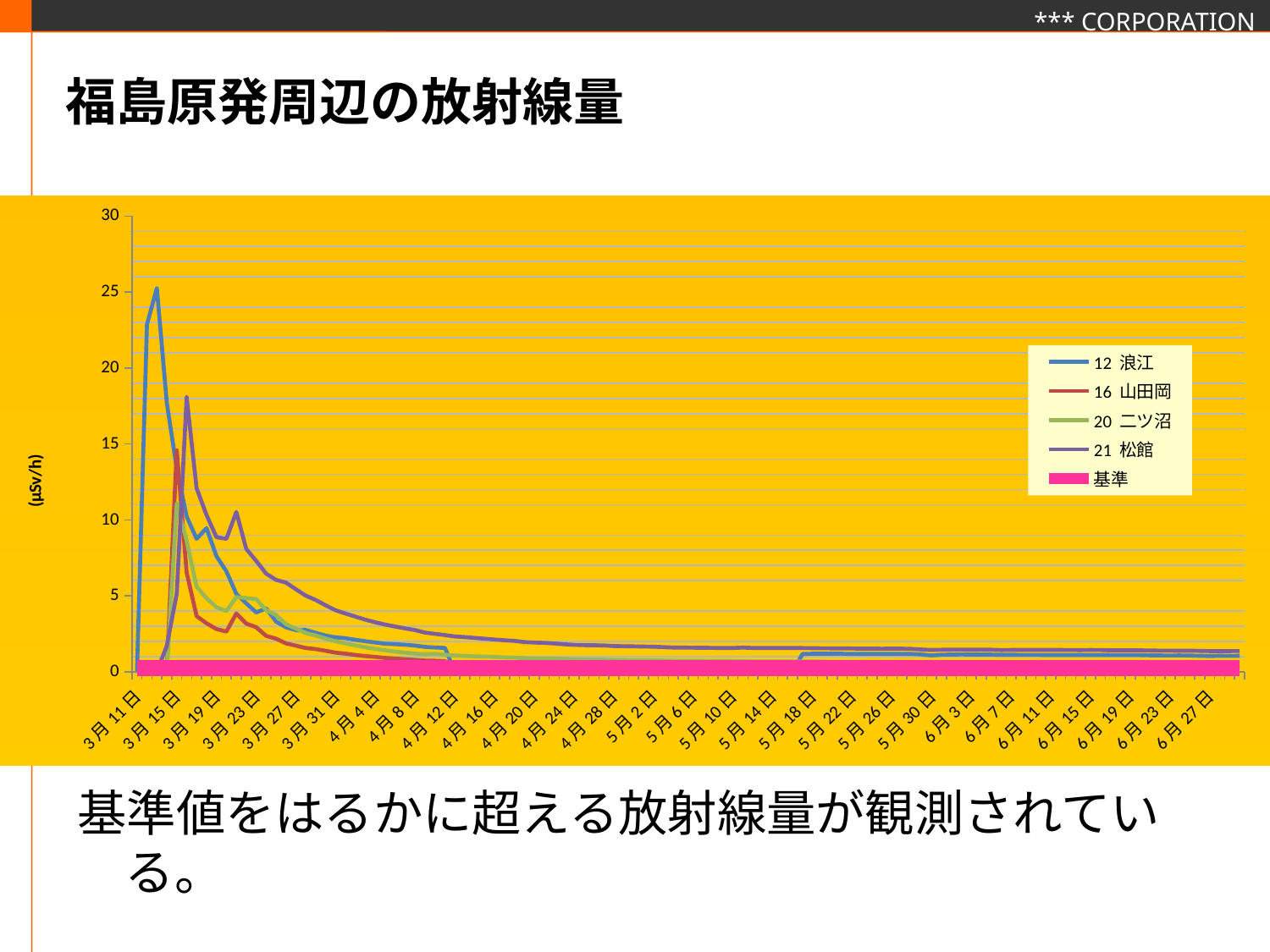
How many series does the legend list? 5 Is the 基準 (reference) line greater or less than 5 μSv/h? less What is the unit shown on the y axis? μSv/h Which series reaches the highest peak value on the chart? 12 浪江 Is the peak value of the 16 山田岡 series greater or less than 20? less What is the maximum value shown on the y axis? 30 What kind of chart is shown on the slide? line chart What is the title of the chart on the slide? 福島原発周辺の放射線量 Is the peak value of the 21 松館 series greater or less than 15? greater Which series has the higher peak, 12 浪江 or 16 山田岡? 12 浪江 After the peaks in mid-March, do the radiation values rise or fall along the x axis? fall